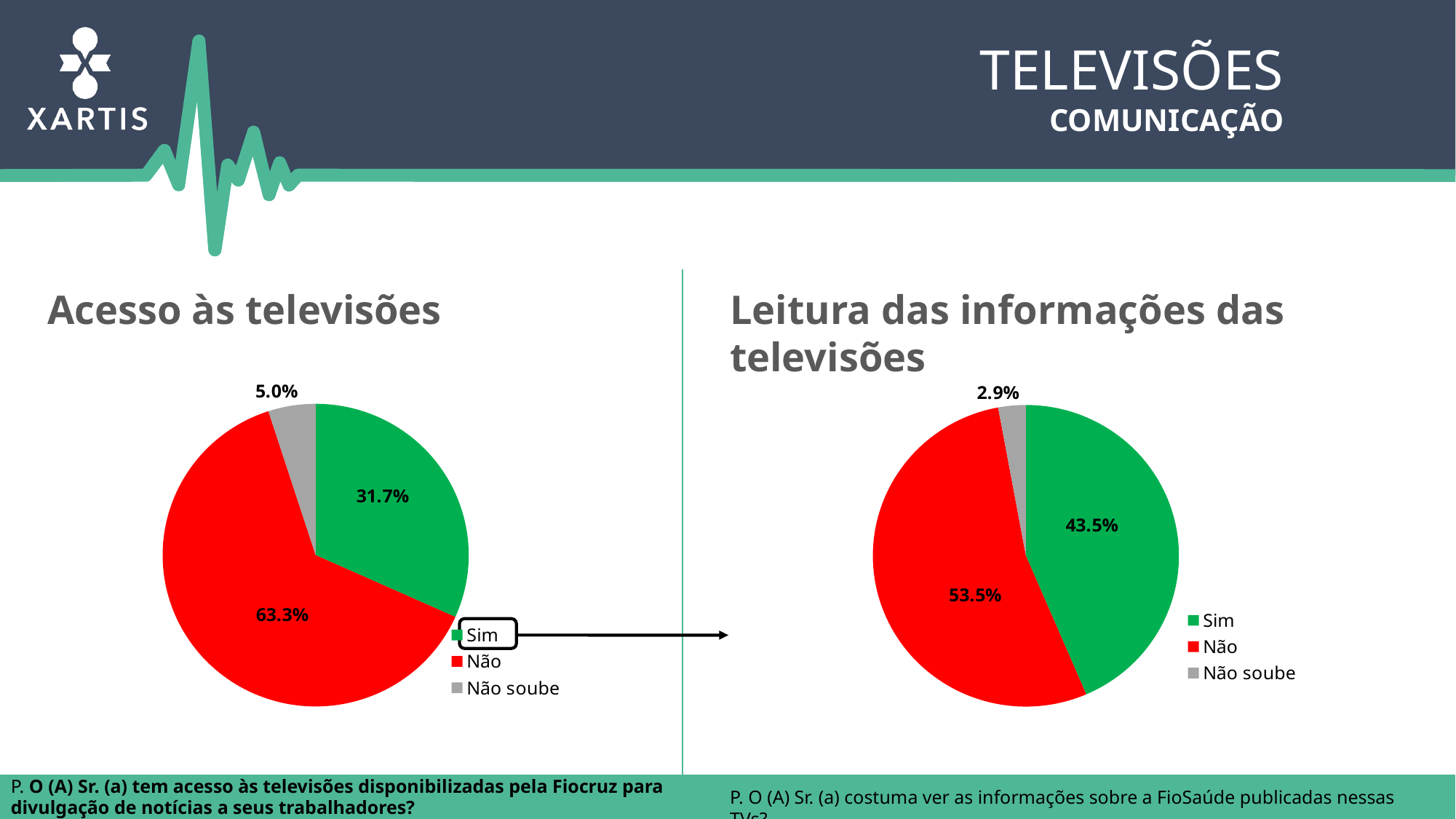
In the 'Leitura das informações das televisões' pie chart, which is larger, 'Sim' or 'Não'? Não In the 'Leitura das informações das televisões' pie chart, which category has the smallest slice? Não soube In the 'Acesso às televisões' pie chart, what percentage is shown for 'Sim'? 31.7% What type of chart is used on the left side of the slide under 'Acesso às televisões'? Pie chart In the 'Leitura das informações das televisões' pie chart, what percentage is shown for 'Não'? 53.5% In the 'Acesso às televisões' pie chart, which category has the largest slice? Não In the 'Leitura das informações das televisões' pie chart, what percentage is shown for 'Sim'? 43.5% In the 'Acesso às televisões' pie chart, what percentage is shown for 'Não'? 63.3% In the 'Acesso às televisões' pie chart, what percentage is shown for 'Não soube'? 5.0% In the 'Acesso às televisões' pie chart, what is the difference in percentage points between 'Não' and 'Sim'? 31.6 How many entries does the legend of the 'Leitura das informações das televisões' chart list? 3 In the 'Leitura das informações das televisões' pie chart, what percentage is shown for 'Não soube'? 2.9%